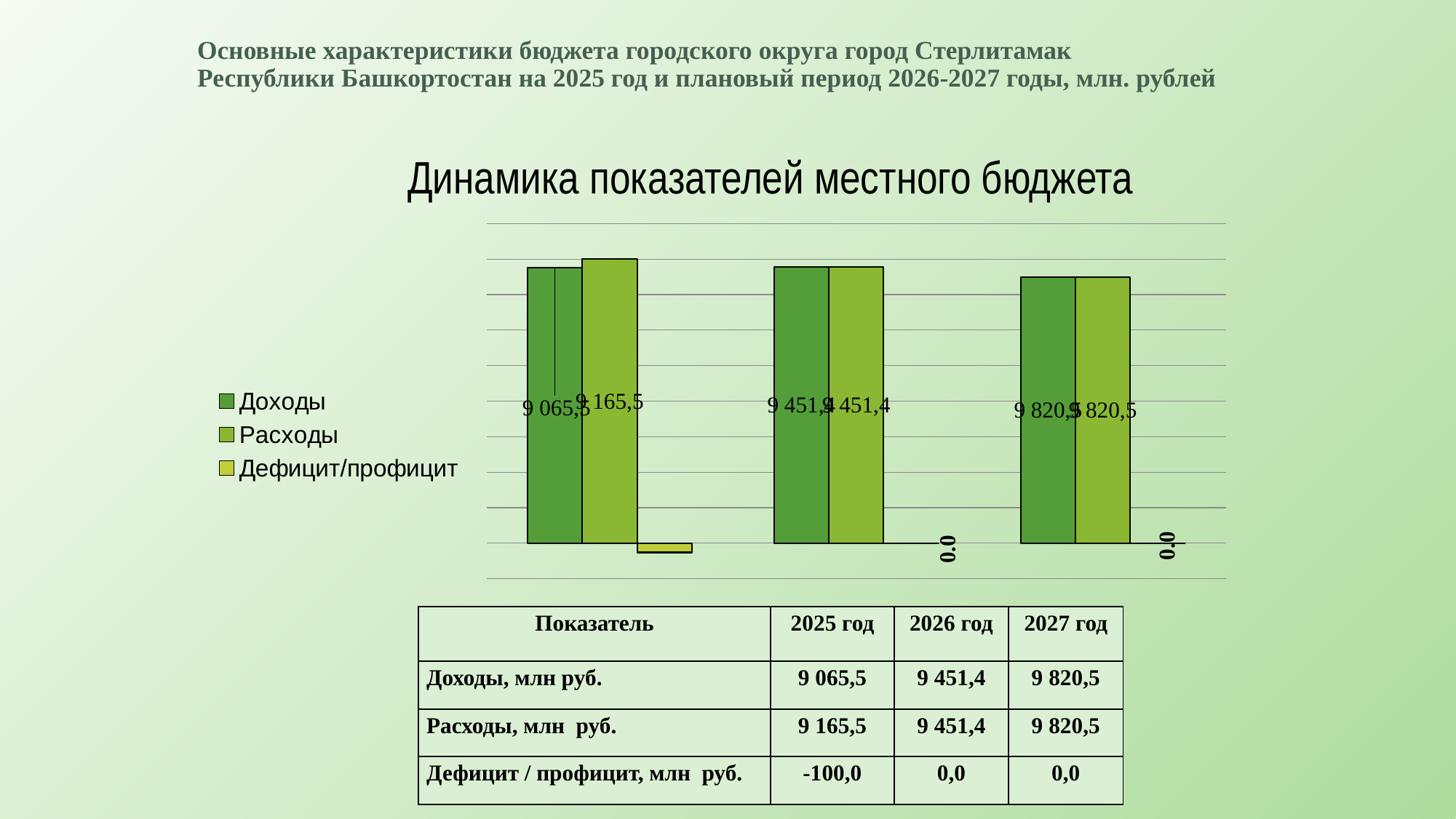
How many series does the chart legend list? 3 In the first group of the chart, which is larger, Доходы or Расходы? Расходы What is the value of the Доходы bar in the third group of the chart? 9 820,5 What is the value of the Расходы bar in the first group of the chart? 9 165,5 What is the value labelled for Дефицит/профицит in the second group of the chart? 0,0 What is the value of the Доходы bar in the first group of the chart? 9 065,5 What is the title of the chart? Динамика показателей местного бюджета What is the difference between Расходы and Доходы in the first group of the chart? 100,0 Do the Доходы values rise or fall from the first group to the third group of the chart? rise Which group of bars has the highest Доходы value in the chart? the third group (2027 год) What kind of chart is shown on the slide? bar chart How many groups of bars are plotted in the chart? 3